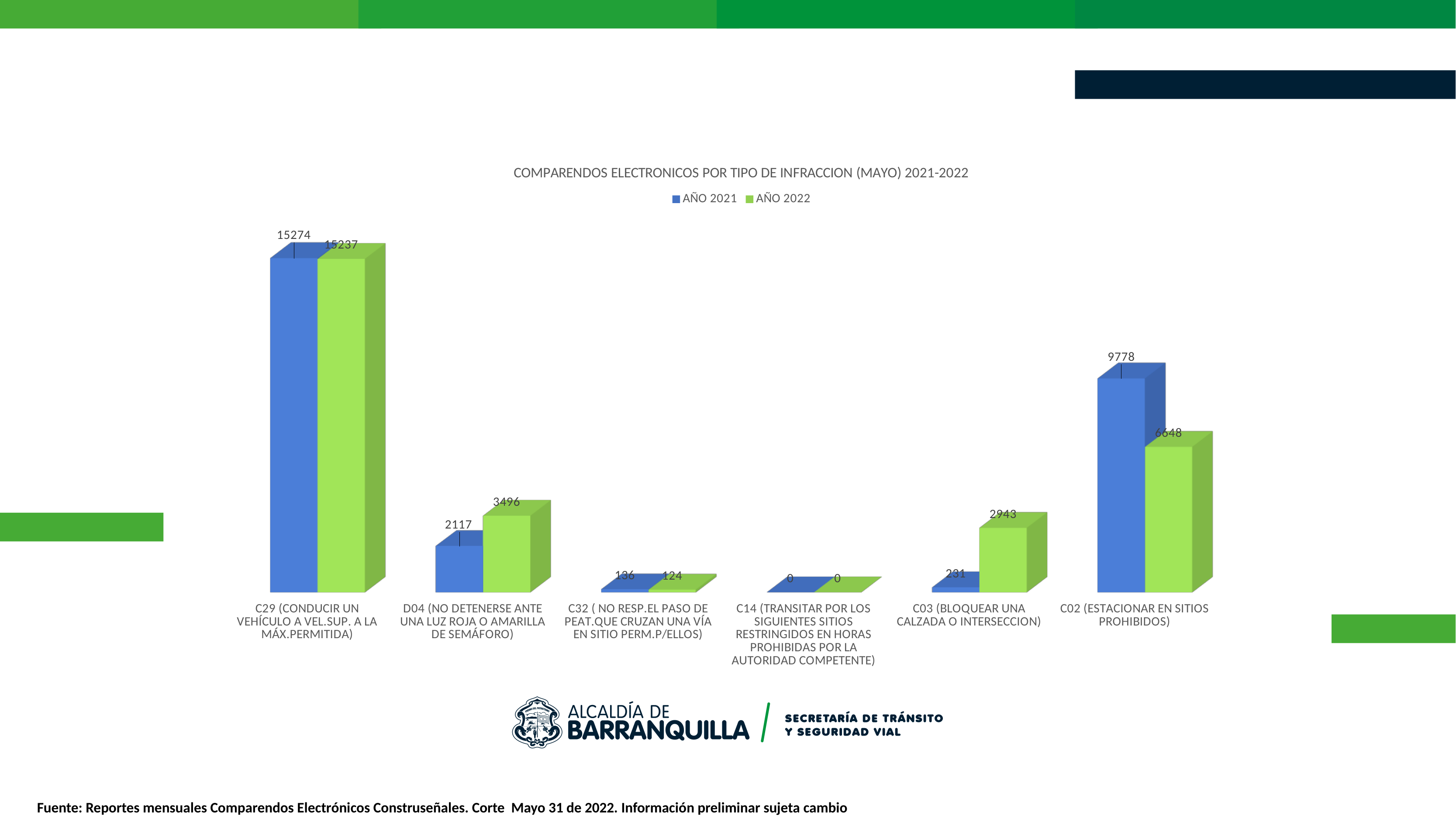
What is the value for AÑO 2022 for C02 (ESTACIONAR EN SITIOS PROHIBIDOS)? 6648 What is the difference between the AÑO 2021 and AÑO 2022 values for C02 (ESTACIONAR EN SITIOS PROHIBIDOS)? 3130 What kind of chart is shown on the slide? Bar chart What is the value for AÑO 2021 for C29 (CONDUCIR UN VEHÍCULO A VEL.SUP. A LA MÁX.PERMITIDA)? 15274 Which category has the lowest value for AÑO 2021? C14 (TRANSITAR POR LOS SIGUIENTES SITIOS RESTRINGIDOS EN HORAS PROHIBIDAS POR LA AUTORIDAD COMPETENTE) What is the value for AÑO 2021 for C03 (BLOQUEAR UNA CALZADA O INTERSECCION)? 231 What is the value for AÑO 2022 for D04 (NO DETENERSE ANTE UNA LUZ ROJA O AMARILLA DE SEMÁFORO)? 3496 For D04 (NO DETENERSE ANTE UNA LUZ ROJA O AMARILLA DE SEMÁFORO), which year has the larger value, AÑO 2021 or AÑO 2022? AÑO 2022 What is the difference between the AÑO 2022 and AÑO 2021 values for C03 (BLOQUEAR UNA CALZADA O INTERSECCION)? 2712 How many series does the legend list? 2 How many infraction categories are shown on the x axis? 6 Which category has the highest value for AÑO 2022? C29 (CONDUCIR UN VEHÍCULO A VEL.SUP. A LA MÁX.PERMITIDA)